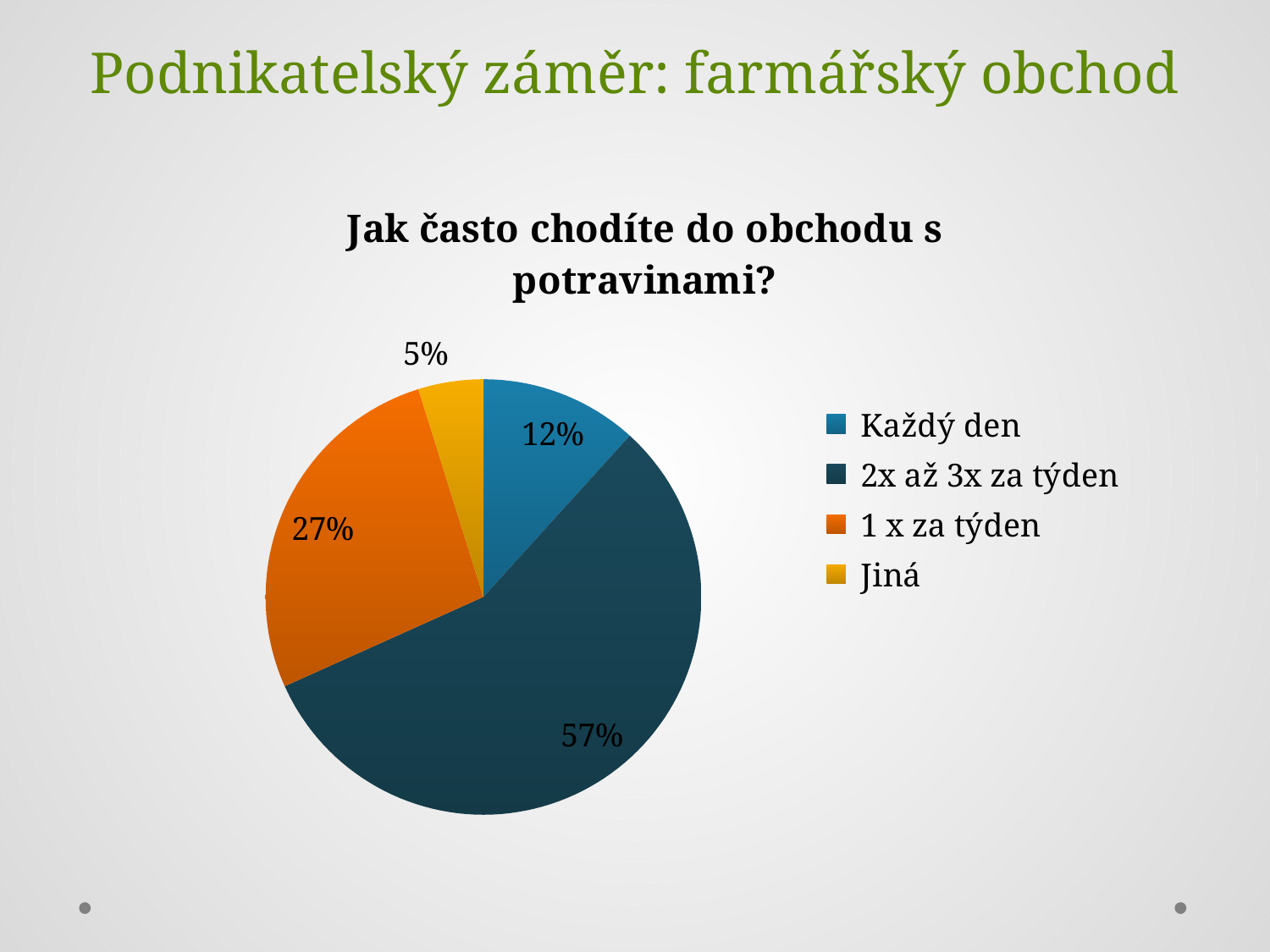
What share of the pie does "2x až 3x za týden" represent? 57% Which is larger, the share for "1 x za týden" or the share for "Každý den"? 1 x za týden What is the title of the chart? Jak často chodíte do obchodu s potravinami? What share of the pie does "Jiná" represent? 5% How many categories does the pie chart show? 4 What kind of chart is shown on the slide? Pie chart What is the difference in percentage points between "2x až 3x za týden" and "1 x za týden"? 30 Which category has the smallest slice of the pie? Jiná What share of the pie does "Každý den" represent? 12% Which category has the largest slice of the pie? 2x až 3x za týden What is the difference in percentage points between "Každý den" and "Jiná"? 7